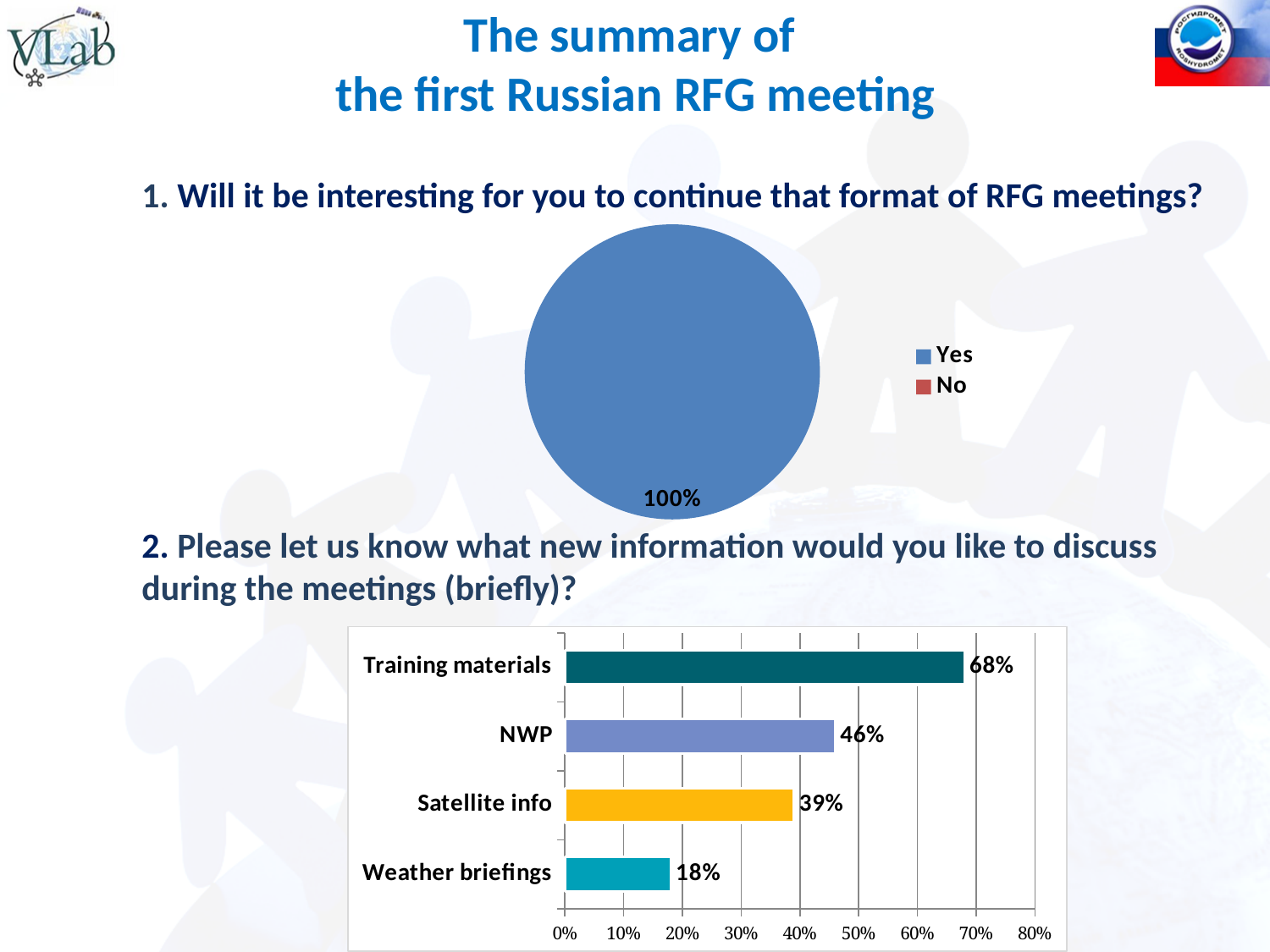
In the pie chart under question 1, what share of responses is 'Yes'? 100% How many entries does the legend of the pie chart under question 1 list? 2 What kind of chart is shown under question 2? bar chart In the bar chart under question 2, how many categories are shown? 4 In the bar chart under question 2, what is the value for NWP? 46% In the bar chart under question 2, which category has the highest value? Training materials In the bar chart under question 2, which category has the lowest value? Weather briefings In the bar chart under question 2, what is the value for Training materials? 68% In the bar chart under question 2, what is the value for Satellite info? 39% In the bar chart under question 2, what is the value for Weather briefings? 18% In the bar chart under question 2, what is the difference between Training materials and NWP? 22% What kind of chart is shown under question 1? pie chart